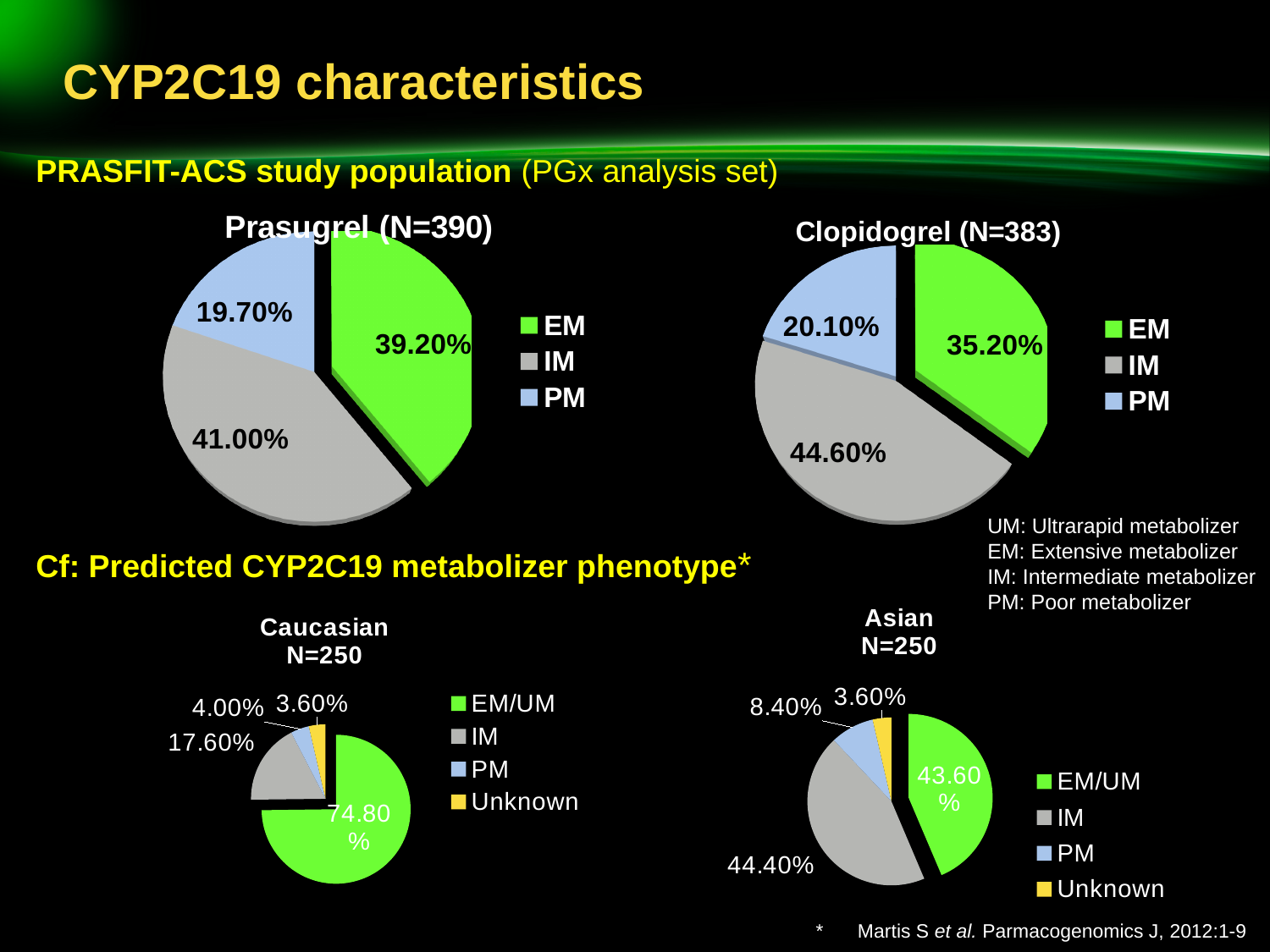
What type of chart is used for the Prasugrel (N=390) data? Pie chart In the Asian N=250 pie chart, what percentage is shown for PM? 8.40% In the Prasugrel (N=390) pie chart, what percentage is shown for IM? 41.00% In the Prasugrel (N=390) pie chart, what is the difference between the IM and EM percentages? 1.80% In the Clopidogrel (N=383) pie chart, which category has the largest share? IM In the Prasugrel (N=390) pie chart, what colour represents PM? Light blue In the Asian N=250 pie chart, what is the difference between the IM and PM percentages? 36.00% In the Clopidogrel (N=383) pie chart, what percentage is shown for PM? 20.10% How many categories does the legend of the Asian N=250 pie chart list? 4 In the Caucasian N=250 pie chart, which category has the smallest share? Unknown Which is larger in the Clopidogrel (N=383) pie chart: the EM share or the PM share? EM In the Caucasian N=250 pie chart, what percentage is shown for EM/UM? 74.80%